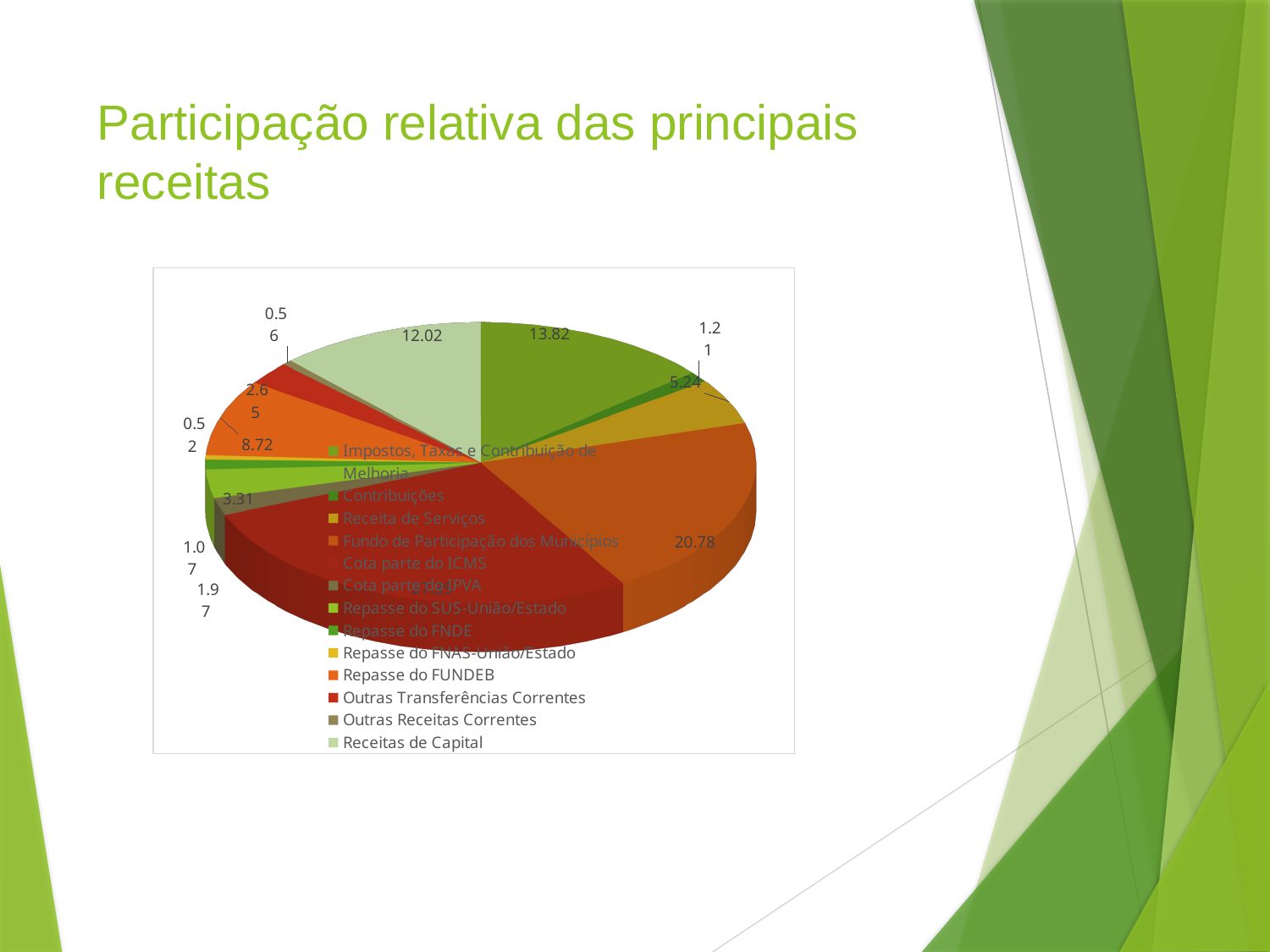
Which is larger, the value for Receitas de Capital or the value for Receita de Serviços? Receitas de Capital What is the title of the slide containing the pie chart? Participação relativa das principais receitas What is the value shown for Receita de Serviços? 5.24 What kind of chart is shown on the slide? pie chart What is the value shown for Impostos, Taxas e Contribuição de Melhoria? 13.82 What is the value shown for Fundo de Participação dos Municípios? 20.78 What is the difference between the values for Fundo de Participação dos Municípios and Receitas de Capital? 8.76 What is the value shown for Repasse do FUNDEB? 8.72 Which is larger, the value for Fundo de Participação dos Municípios or the value for Impostos, Taxas e Contribuição de Melhoria? Fundo de Participação dos Municípios What is the difference between the values for Impostos, Taxas e Contribuição de Melhoria and Repasse do FUNDEB? 5.1 What is the value shown for Receitas de Capital? 12.02 How many categories does the legend of the pie chart list? 13